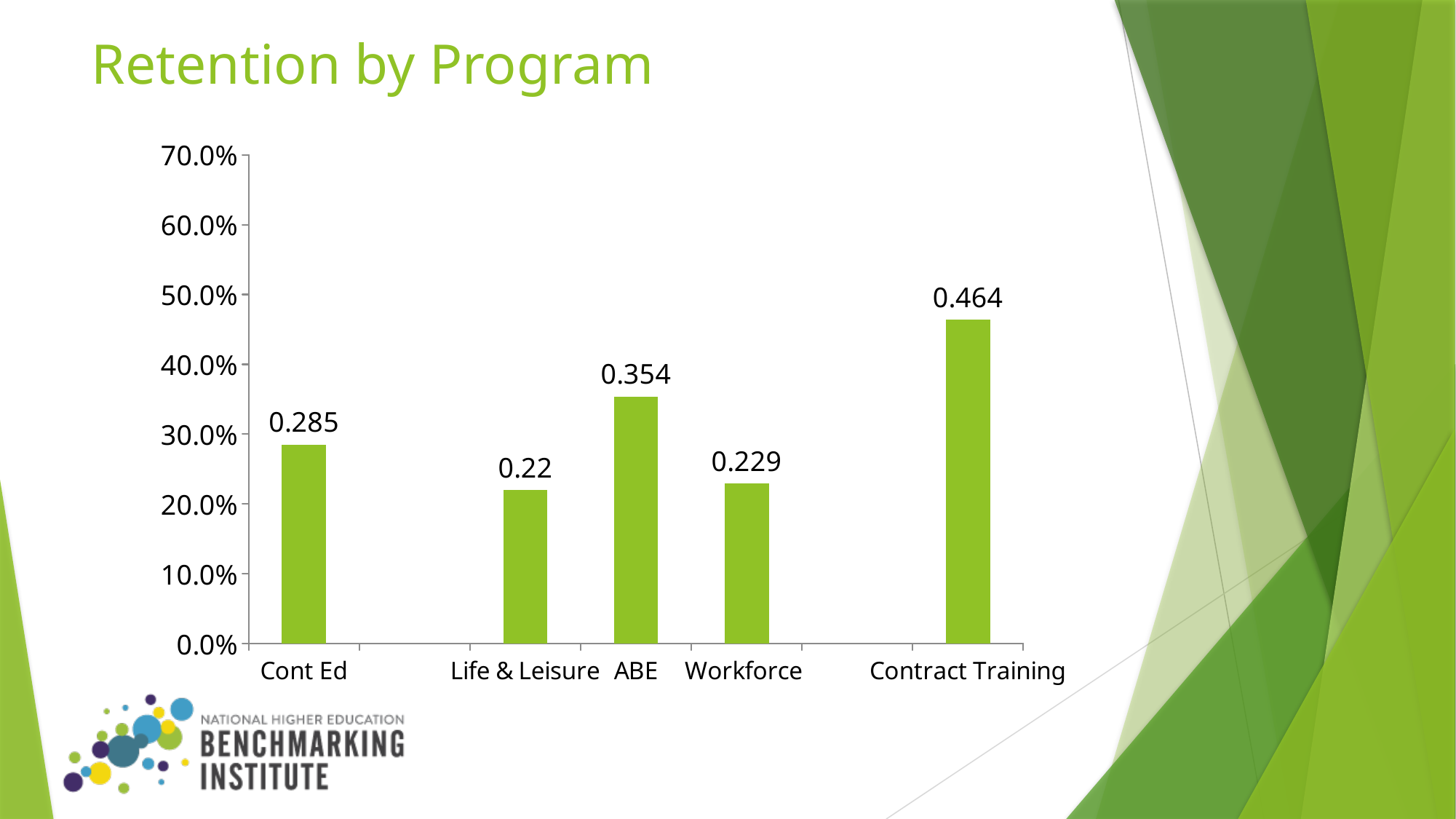
How many programs are shown on the x axis? 5 What is the data label shown for Contract Training? 0.464 What is the data label shown for ABE? 0.354 What is the data label shown for Workforce? 0.229 What kind of chart is shown on the slide? Bar chart Which program has the highest retention? Contract Training What is the difference between the data labels for Contract Training and ABE? 0.11 Is the value for Contract Training greater or less than 40.0%? greater What is the difference between the data labels for Cont Ed and Life & Leisure? 0.065 Which is larger, the value for ABE or the value for Cont Ed? ABE What is the data label shown for Life & Leisure? 0.22 Which program has the lowest retention? Life & Leisure